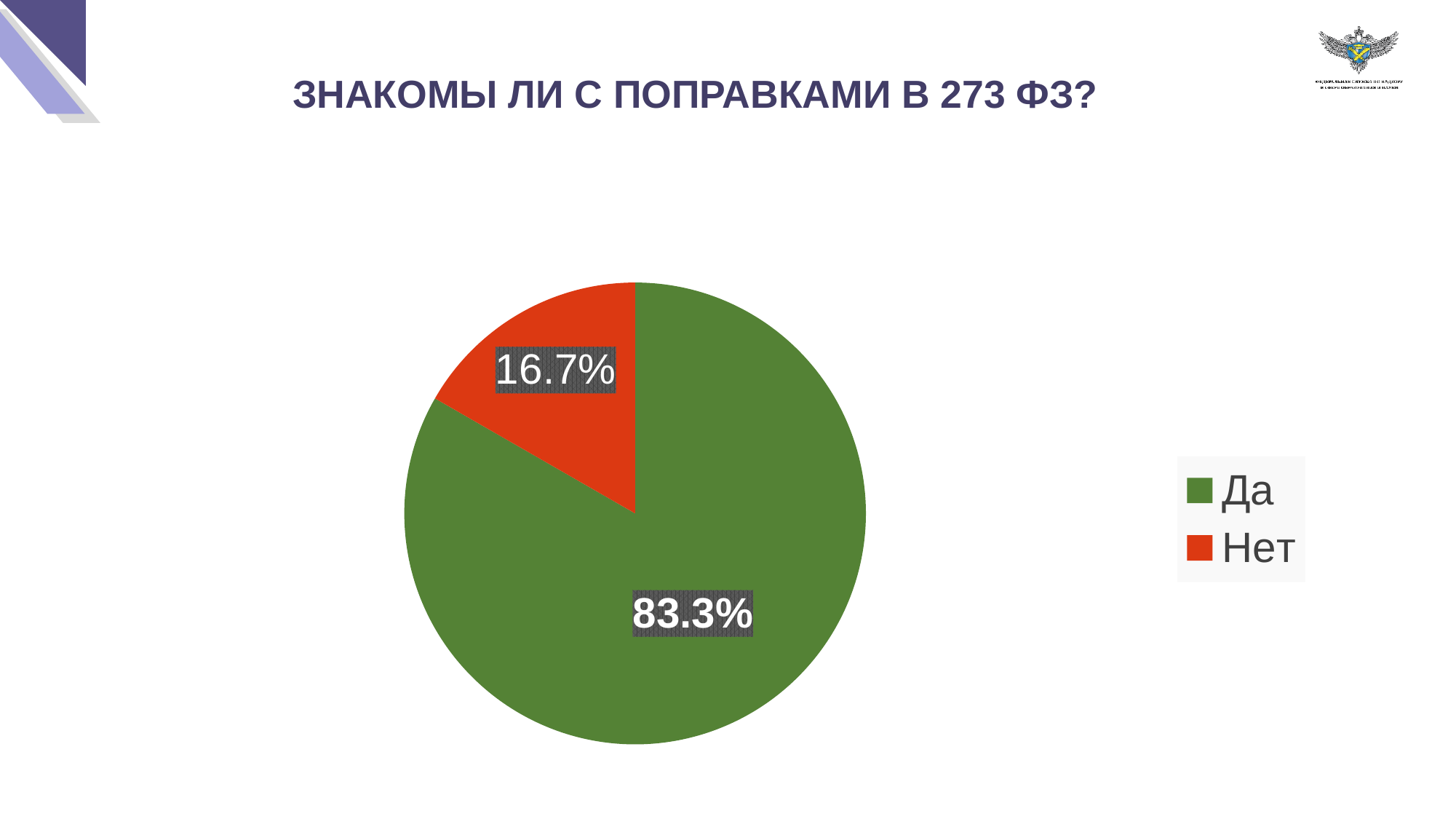
Which category has the largest share of the pie? Да What is the value for Нет? 16.7% What is the difference between the values for Да and Нет? 66.6% What is the title of the slide above the chart? ЗНАКОМЫ ЛИ С ПОПРАВКАМИ В 273 ФЗ? Which is larger, the value for Да or the value for Нет? Да What is the value for Да? 83.3% How many entries does the legend list? 2 What type of chart is shown on the slide? pie chart Which category has the smallest share of the pie? Нет What colour is the Нет slice? red What share of the pie does the Нет slice represent? 16.7% How many slices does the pie chart have? 2